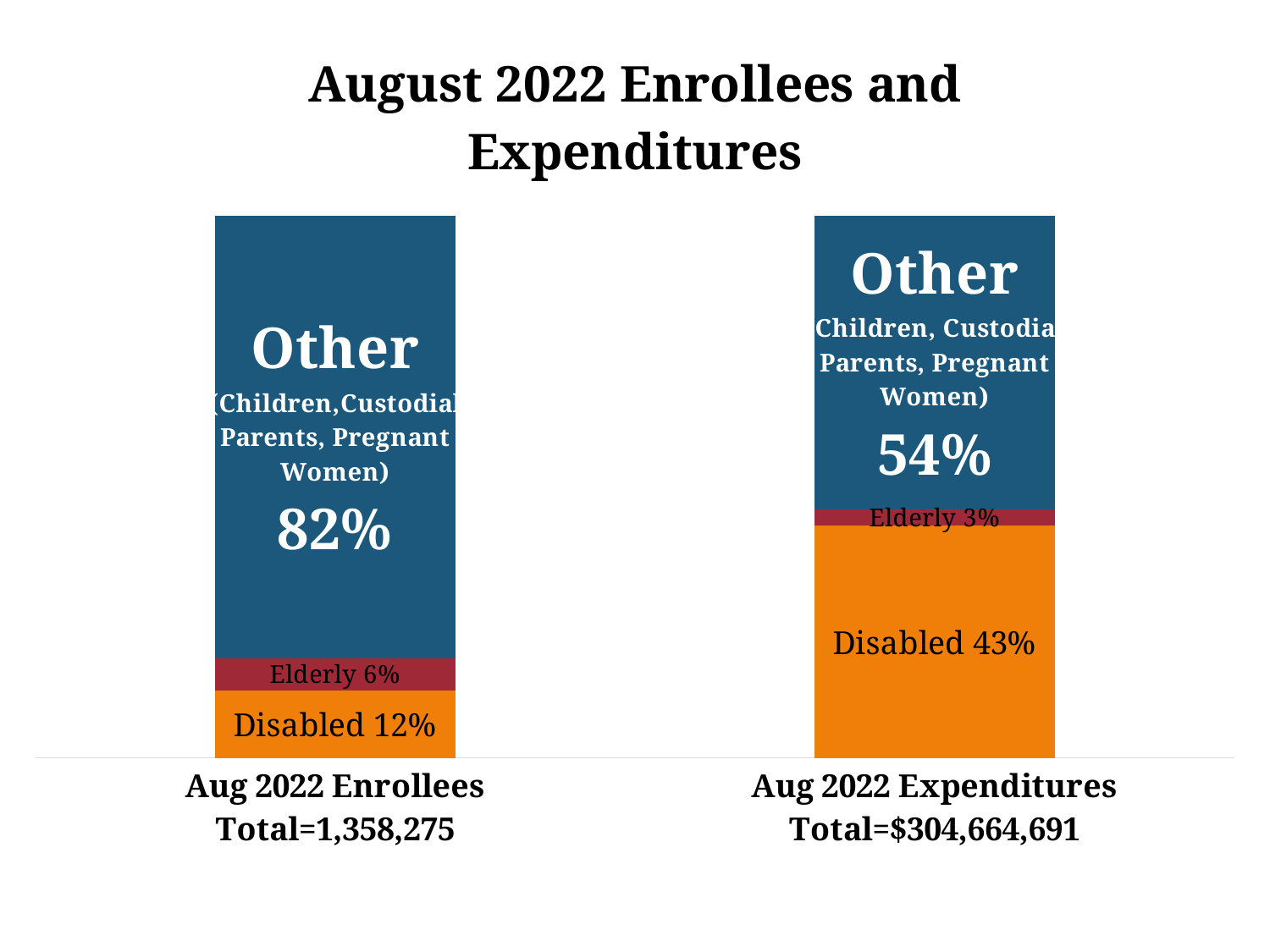
Which group has the largest share of Aug 2022 Enrollees? Other (Children, Custodial Parents, Pregnant Women) What share of Aug 2022 Enrollees is Disabled? 12% Is the Disabled share larger for Aug 2022 Enrollees or Aug 2022 Expenditures? Aug 2022 Expenditures What share of Aug 2022 Expenditures is Other (Children, Custodial Parents, Pregnant Women)? 54% What share of Aug 2022 Enrollees is Elderly? 6% What share of Aug 2022 Expenditures is Disabled? 43% How many bars are shown on the chart? 2 What share of Aug 2022 Expenditures is Elderly? 3% What kind of chart is shown on the slide? Stacked bar chart What is the difference between the Other share of Aug 2022 Enrollees and the Other share of Aug 2022 Expenditures? 28 percentage points What is the total for Aug 2022 Expenditures as stated on the slide? $304,664,691 Which group has the smallest share of Aug 2022 Expenditures? Elderly